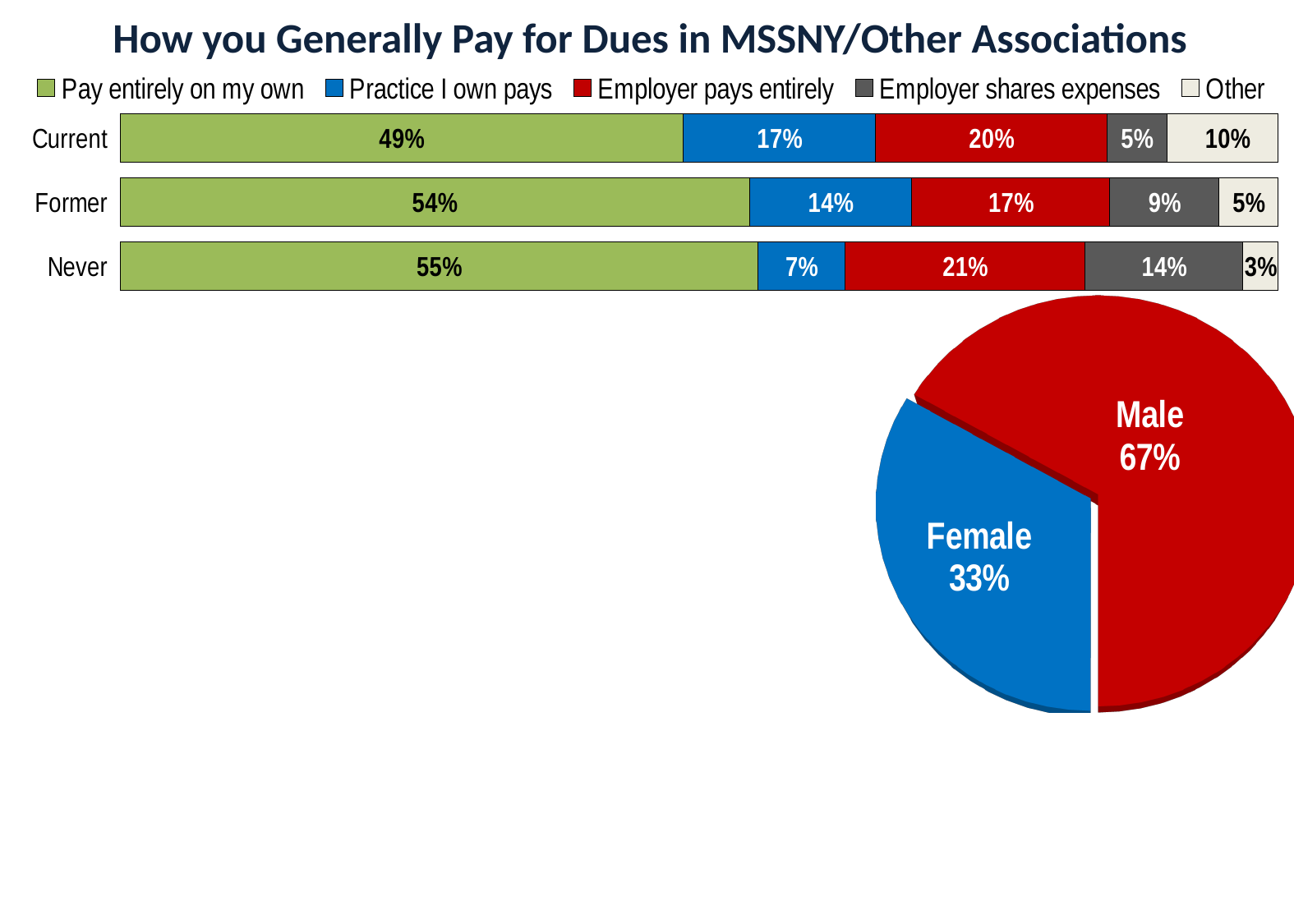
In the pie chart at the bottom right, which slice is larger, Male or Female? Male In the stacked bar chart, what is the 'Employer pays entirely' value for the Never category? 21% In the stacked bar chart, what is the difference between the 'Other' values for Current and Never? 7% In the stacked bar chart, which category has the highest 'Pay entirely on my own' share? Never In the stacked bar chart, is the 'Employer shares expenses' value larger for Current or for Never? Never In the pie chart at the bottom right, what share is Female? 33% How many categories are shown in the stacked bar chart? 3 In the stacked bar chart, what is the 'Employer shares expenses' value for Former members? 9% In the stacked bar chart, which category has the lowest 'Practice I own pays' share? Never In the stacked bar chart 'How you Generally Pay for Dues in MSSNY/Other Associations', what percentage of Current members pay entirely on their own? 49% What kind of chart is the chart at the top of the slide? Stacked bar chart How many series does the legend of the stacked bar chart list? 5